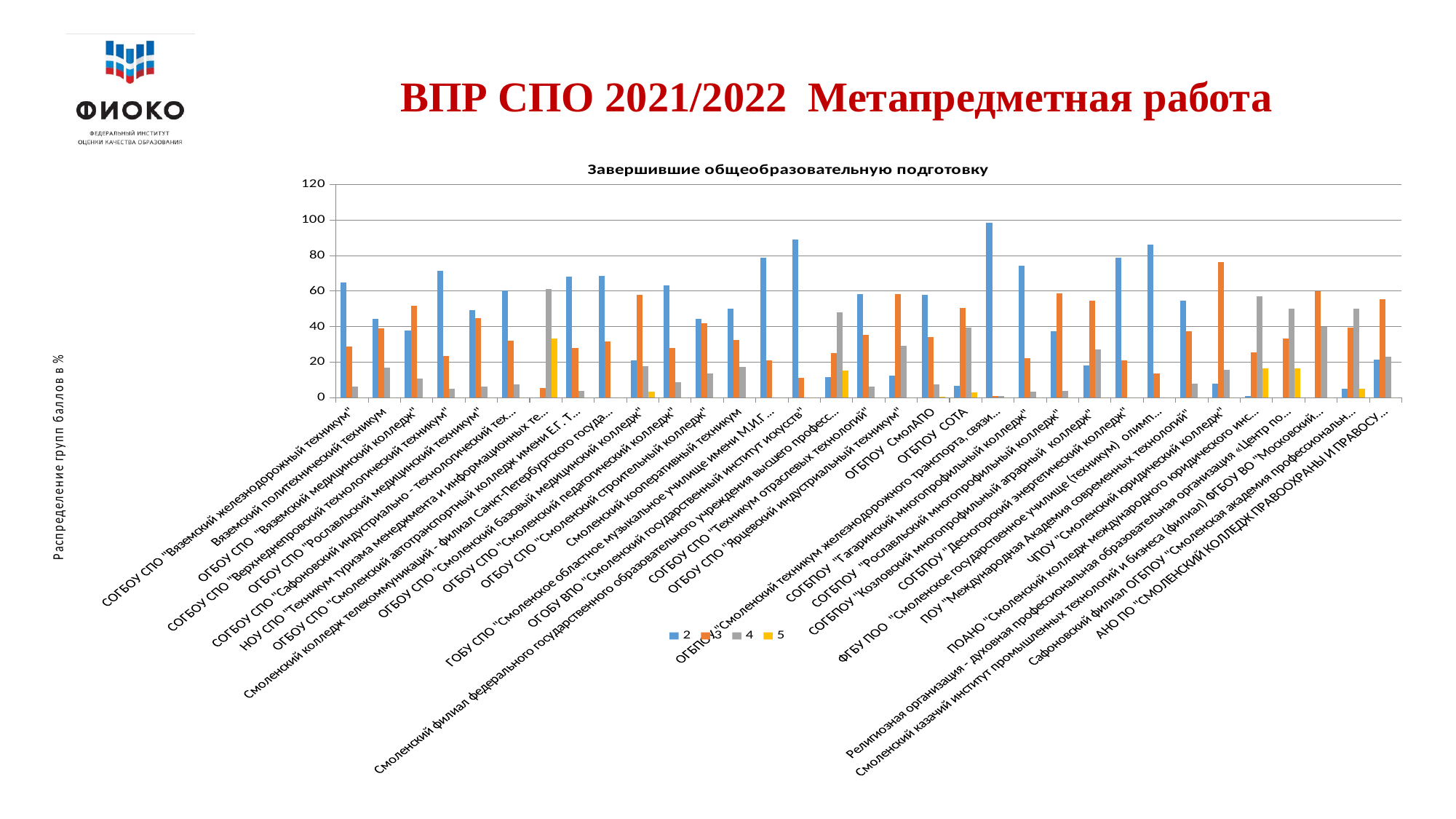
What is the title of the chart? Завершившие общеобразовательную подготовку Which has the larger value for series 2: СОГБПОУ "Гагаринский многопрофильный колледж" or СОГБПОУ "Рославльский многопрофильный колледж"? СОГБПОУ "Гагаринский многопрофильный колледж" Is the value of series 2 for ОГБПОУ СмолАПО greater or less than 40? greater Is the value of series 2 for ГОБУ ВПО "Смоленский государственный институт искусств" greater or less than 80? greater For ОГБОУ СПО "Ярцевский индустриальный техникум", which series has the larger value, 2 or 3? 3 Is the value of series 3 for ЧПОУ "Смоленский юридический колледж" greater or less than 60? greater What are the entries in the chart's legend? 2, 3, 4, 5 What kind of chart is shown on the slide? Bar chart For ОГБПОУ СмолАПО, which series has the larger value, 2 or 3? 2 How many series does the legend of the chart list? 4 Which category has the highest value for series 3? ЧПОУ "Смоленский юридический колледж"